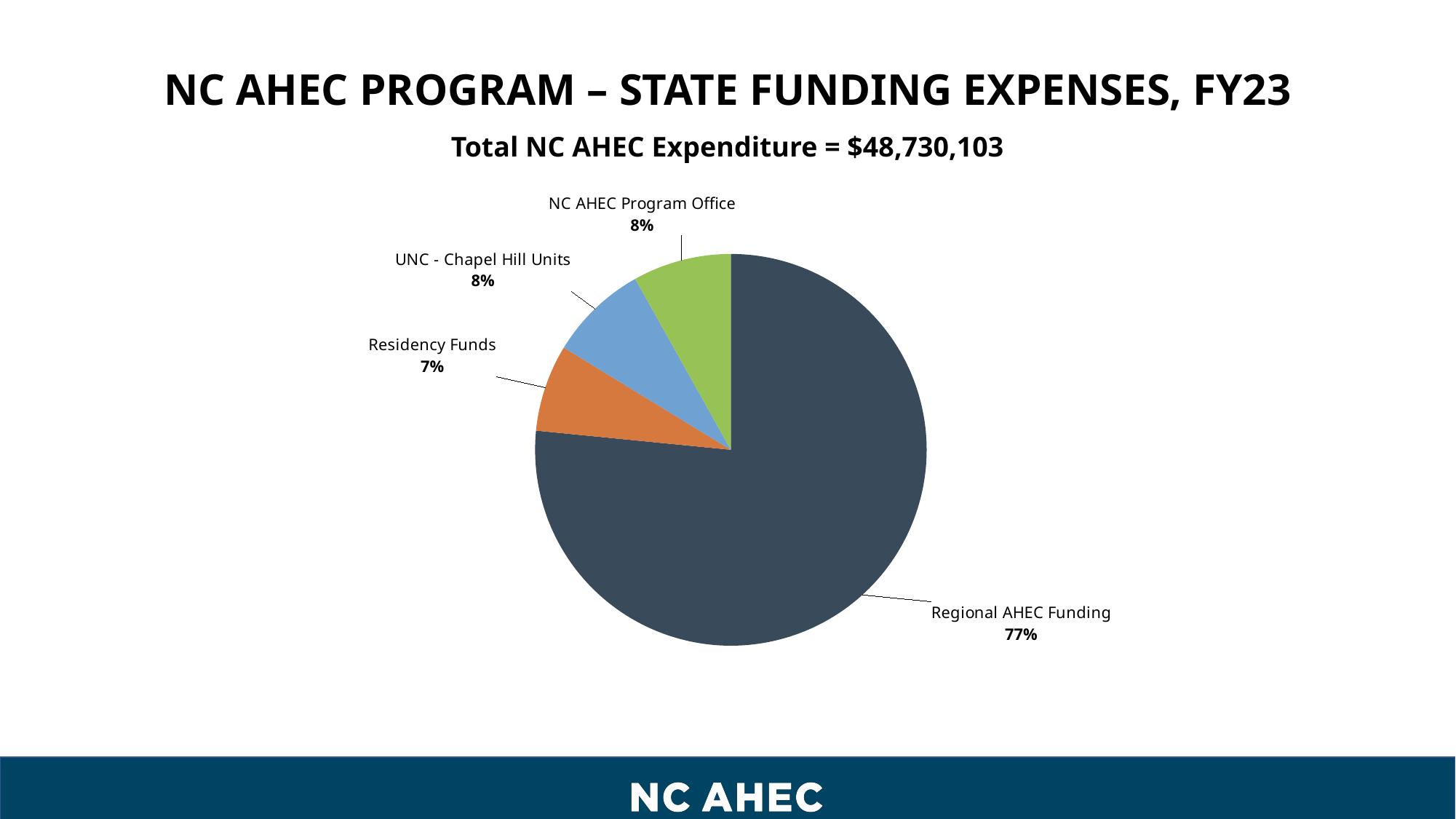
How many categories are shown in the pie chart? 4 What is the difference in percentage points between Regional AHEC Funding and Residency Funds? 70 What percentage is shown for Residency Funds? 7% Which category has the smallest slice of the pie? Residency Funds Which is larger, the share for Regional AHEC Funding or the share for NC AHEC Program Office? Regional AHEC Funding What kind of chart is shown on the slide? Pie chart What percentage is shown for UNC - Chapel Hill Units? 8% Which category has the largest slice of the pie? Regional AHEC Funding What share of the pie does Regional AHEC Funding represent? 77% What is the total NC AHEC expenditure stated on the slide? $48,730,103 What colour is the Regional AHEC Funding slice? Dark blue-grey What percentage is shown for NC AHEC Program Office? 8%